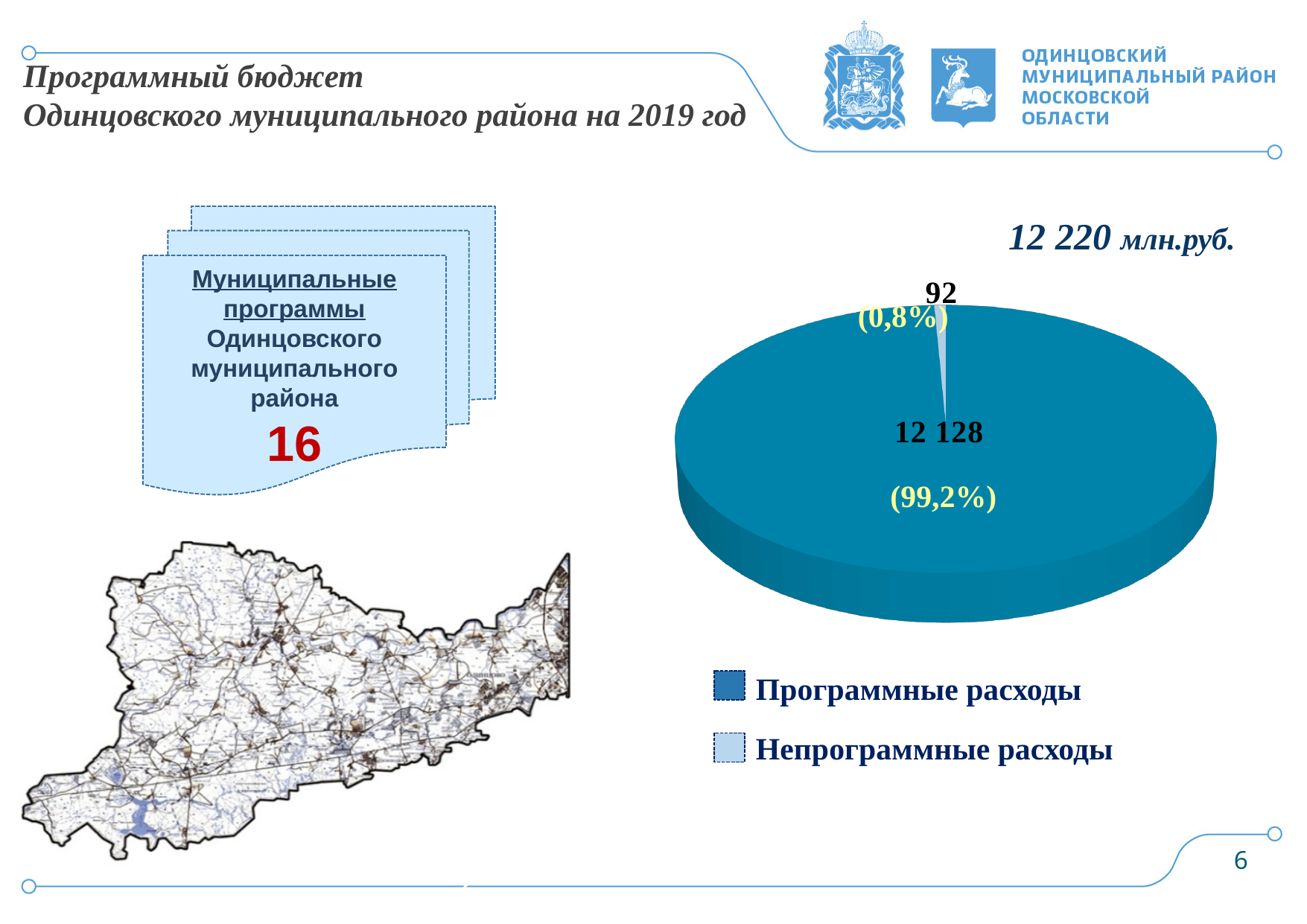
What is the value for Программные расходы in the pie chart? 12 128 What kind of chart is shown on the slide? pie chart How many entries does the legend of the pie chart list? 2 How many slices does the pie chart have? 2 What total amount is shown above the pie chart? 12 220 млн.руб. Which slice of the pie chart is the smallest? Непрограммные расходы What share of the pie does Непрограммные расходы represent? 0,8% What is the difference between the values for Программные расходы and Непрограммные расходы? 12 036 Which is larger, Программные расходы or Непрограммные расходы? Программные расходы Which slice of the pie chart is the largest? Программные расходы What is the value for Непрограммные расходы in the pie chart? 92 What share of the pie does Программные расходы represent? 99,2%